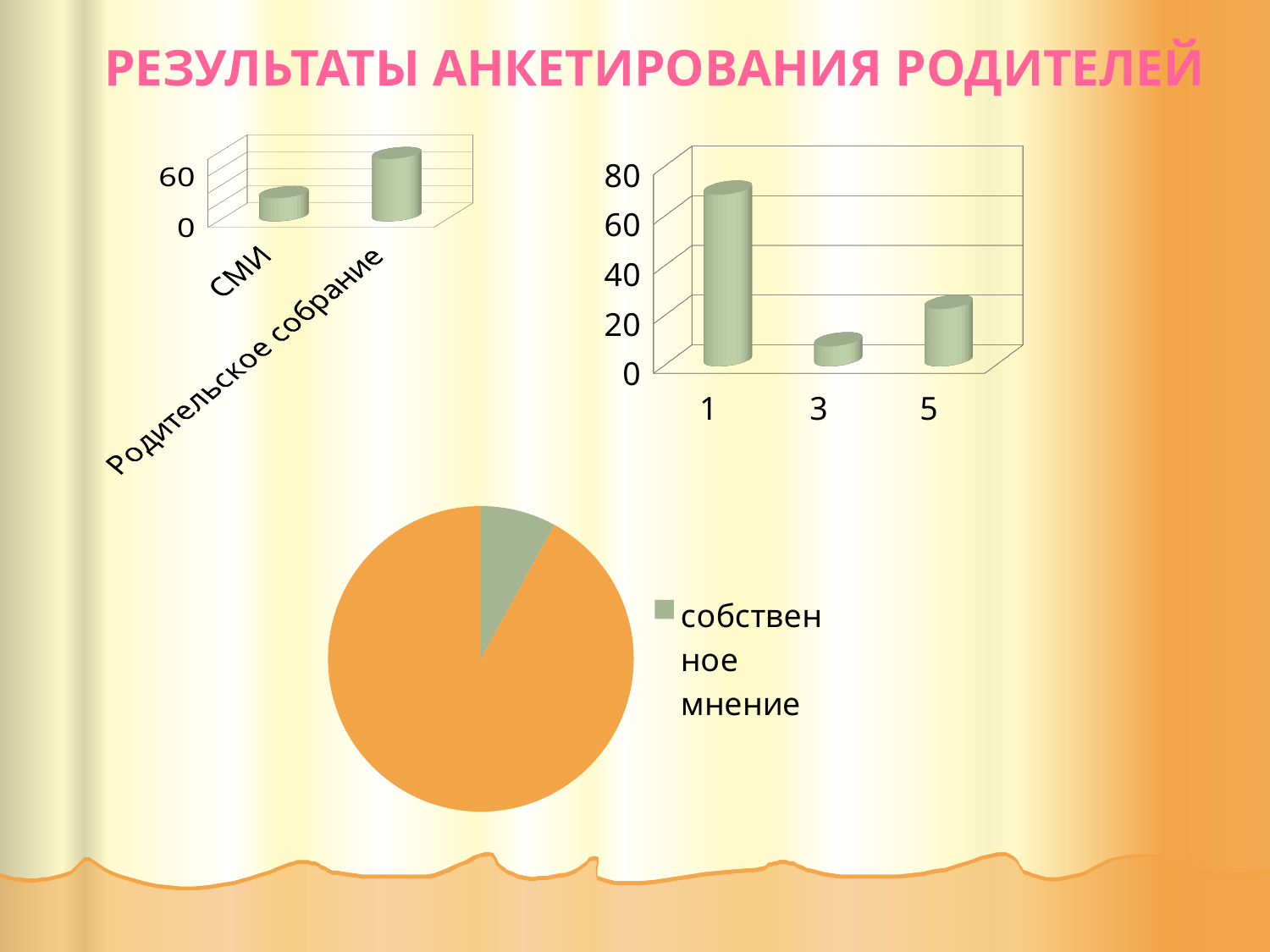
In the top-left bar chart, which category has the higher value, СМИ or Родительское собрание? Родительское собрание In the top-left bar chart, is the value for СМИ greater or less than 60? less What kind of chart is the chart in the top-right of the slide? bar chart In the top-right bar chart, which category has the lowest value? 3 In the top-right bar chart, is the value for category 1 greater or less than 60? greater How many categories are shown in the top-left bar chart? 2 In the top-left bar chart, which category has the lowest value? СМИ In the top-right bar chart, is the value for category 5 greater or less than 40? less In the top-right bar chart, which category has the highest value? 1 What kind of chart is the chart in the top-left of the slide? bar chart What kind of chart is the chart at the bottom of the slide? pie chart